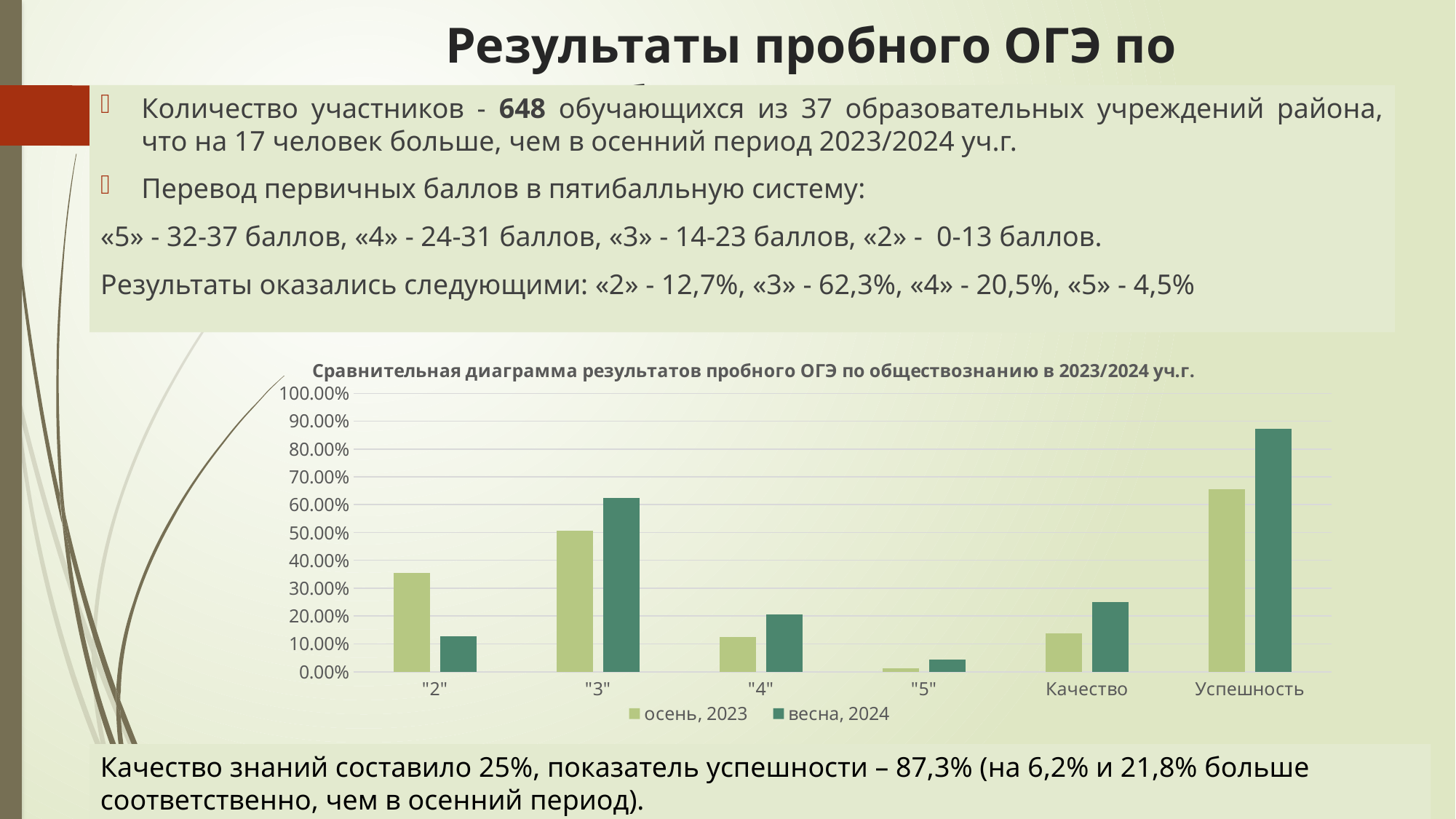
Which category has the highest value for the весна, 2024 series? Успешность Is the value for Успешность in the осень, 2023 series greater or less than 60.00%? greater What kind of chart is shown on the slide? bar chart Is the value for Качество in the весна, 2024 series greater or less than 30.00%? less Which category has the lowest value for the осень, 2023 series? "5" How many series does the chart legend list? 2 Is the value for "2" in the осень, 2023 series greater or less than 30.00%? greater For the category "2", which series has the larger value: осень, 2023 or весна, 2024? осень, 2023 How many categories are shown on the x axis of the chart? 6 For the category "3", which series has the larger value: осень, 2023 or весна, 2024? весна, 2024 What are the two series named in the chart legend? осень, 2023 and весна, 2024